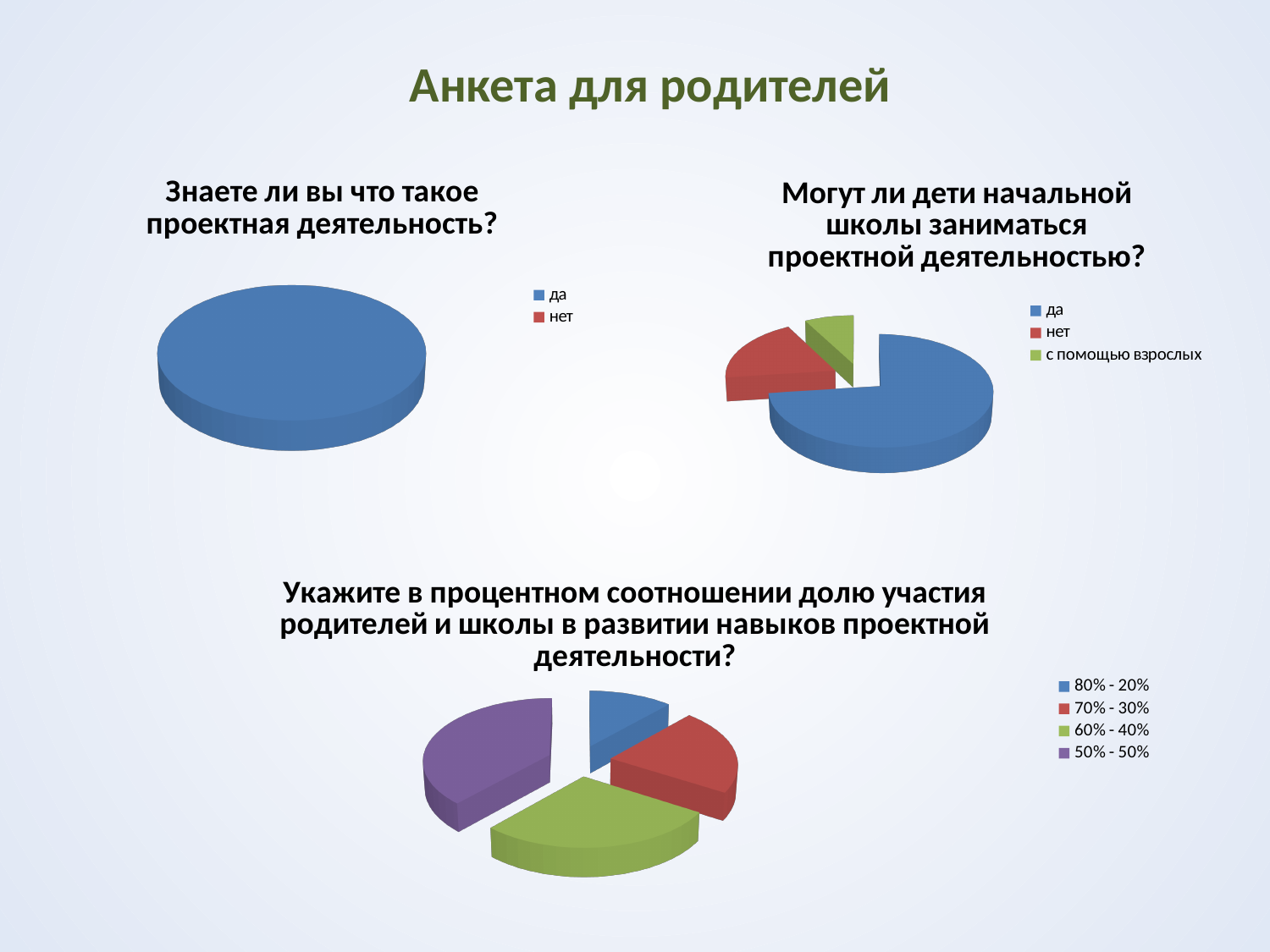
What kind of chart is used for "Знаете ли вы что такое проектная деятельность?"? pie chart In the chart "Могут ли дети начальной школы заниматься проектной деятельностью?", which answer has the smallest slice? с помощью взрослых In the bottom chart "Укажите в процентном соотношении долю участия родителей и школы...", which category has the smallest slice? 80% - 20% In the chart "Могут ли дети начальной школы заниматься проектной деятельностью?", which slice is larger: "нет" or "с помощью взрослых"? нет In the chart "Знаете ли вы что такое проектная деятельность?", which answer has the largest share? да In the bottom chart "Укажите в процентном соотношении долю участия родителей и школы...", which slice is larger: "80% - 20%" or "70% - 30%"? 70% - 30% In the bottom chart "Укажите в процентном соотношении долю участия родителей и школы...", how many entries does the legend list? 4 In the chart "Могут ли дети начальной школы заниматься проектной деятельностью?", how many entries does the legend list? 3 How many pie charts are shown on the slide? 3 In the chart "Могут ли дети начальной школы заниматься проектной деятельностью?", which answer has the largest slice? да In the bottom chart "Укажите в процентном соотношении долю участия родителей и школы...", what colour is the "50% - 50%" slice? purple In the chart "Знаете ли вы что такое проектная деятельность?", how many entries does the legend list? 2